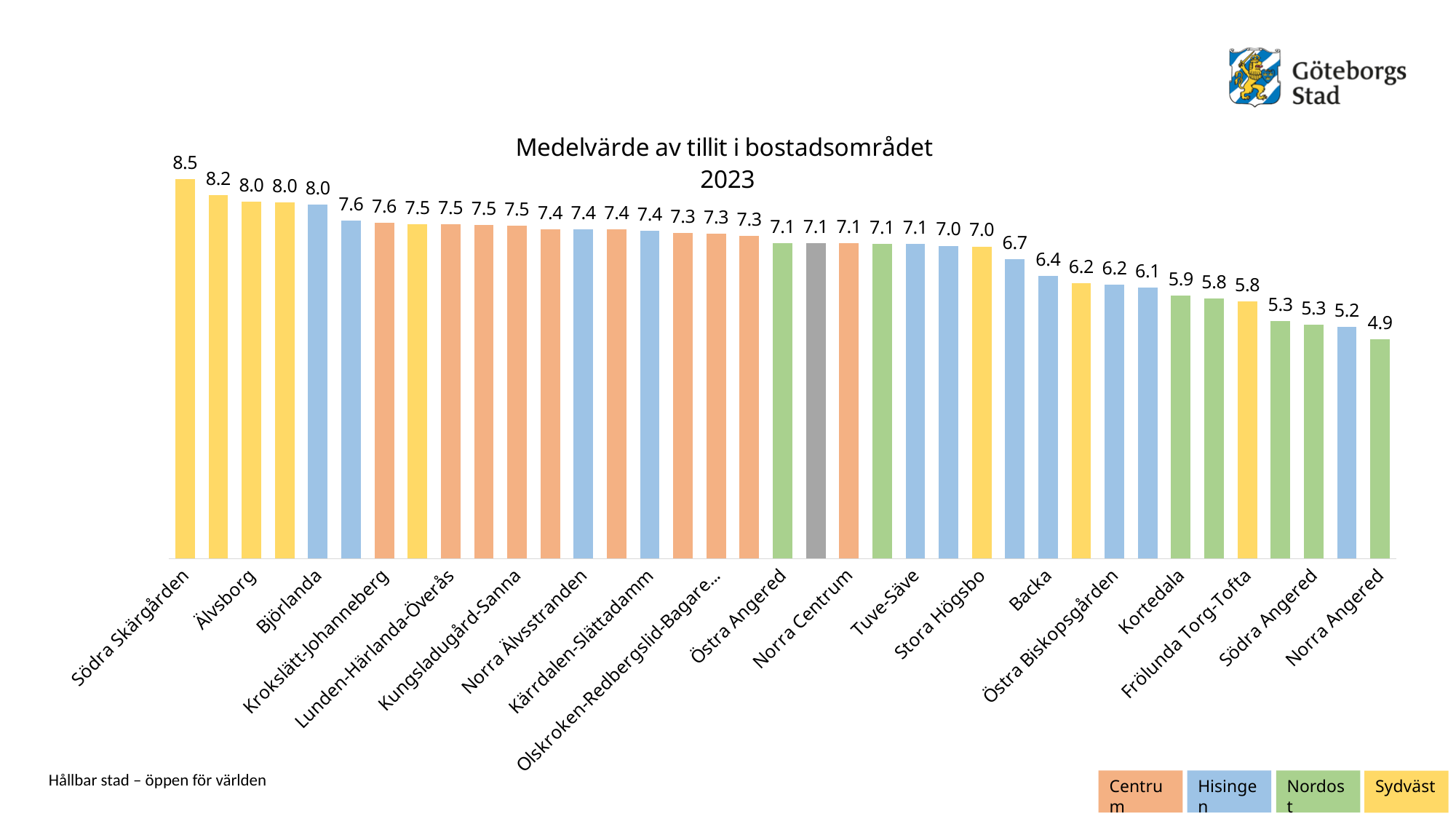
Which area has the highest value? Södra Skärgården How many entries does the legend list? 4 Which is larger, the value for Björlanda or the value for Östra Biskopsgården? Björlanda What is the value for Norra Angered? 4.9 What is the difference between the values for Södra Skärgården and Norra Angered? 3.6 What is the value for Södra Skärgården? 8.5 What is the value for Kortedala? 5.9 Do the values rise or fall from left to right along the x axis? fall What is the value for Backa? 6.4 Which area has the lowest value? Norra Angered What kind of chart is shown? bar chart What is the title of the chart? Medelvärde av tillit i bostadsområdet 2023